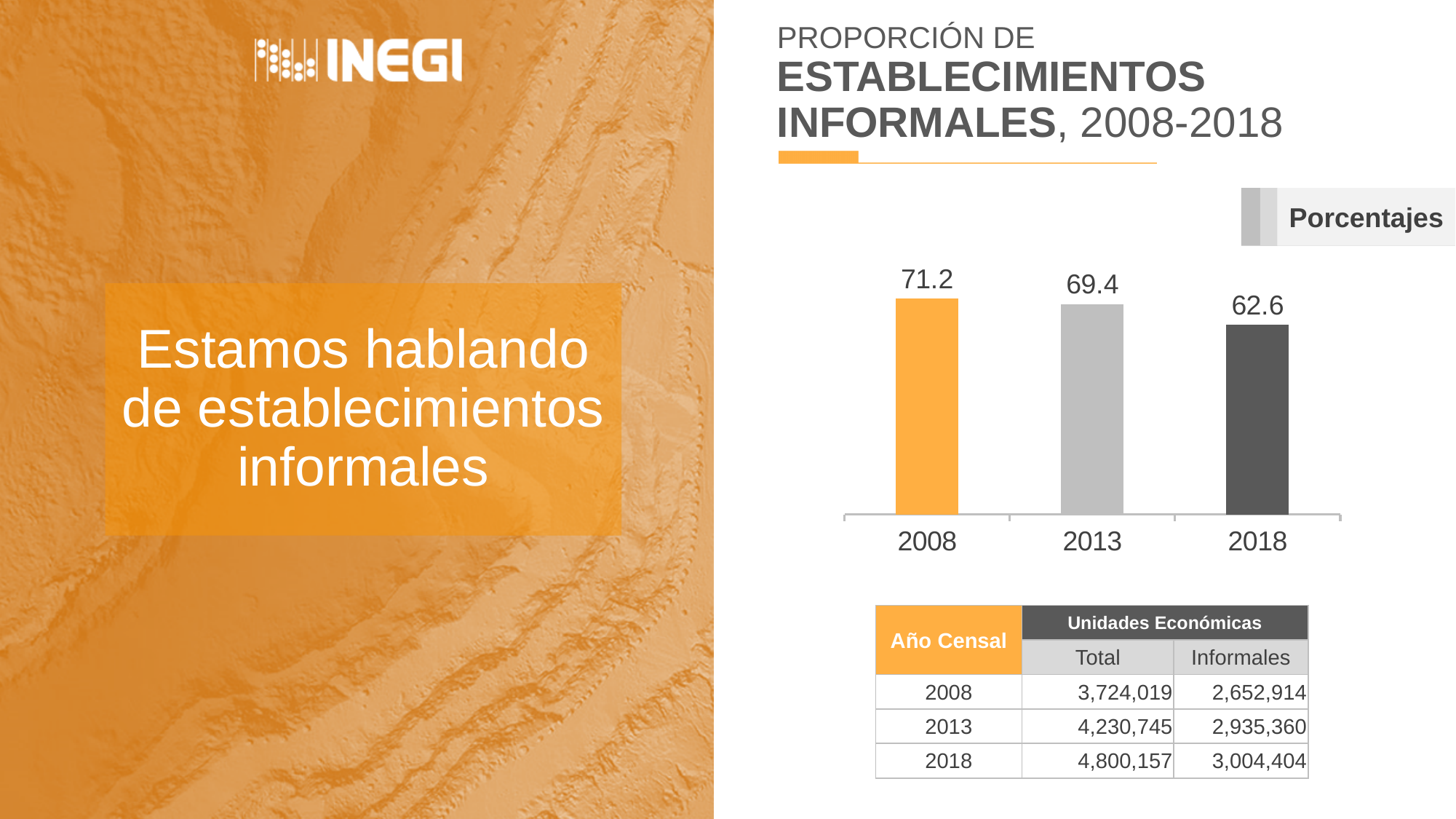
What is the value for 2013 in the bar chart? 69.4 How many years are shown in the bar chart? 3 Do the values in the bar chart rise or fall from 2008 to 2018? fall What is the value for 2018 in the bar chart? 62.6 What kind of chart is shown on the slide? bar chart Which year has the highest value in the bar chart? 2008 What unit label is shown in the box at the top right of the chart? Porcentajes Which is larger in the bar chart, the value for 2013 or the value for 2018? 2013 Which year has the lowest value in the bar chart? 2018 What is the difference between the values for 2008 and 2018 in the bar chart? 8.6 What is the value for 2008 in the bar chart? 71.2 What is the difference between the values for 2013 and 2018 in the bar chart? 6.8